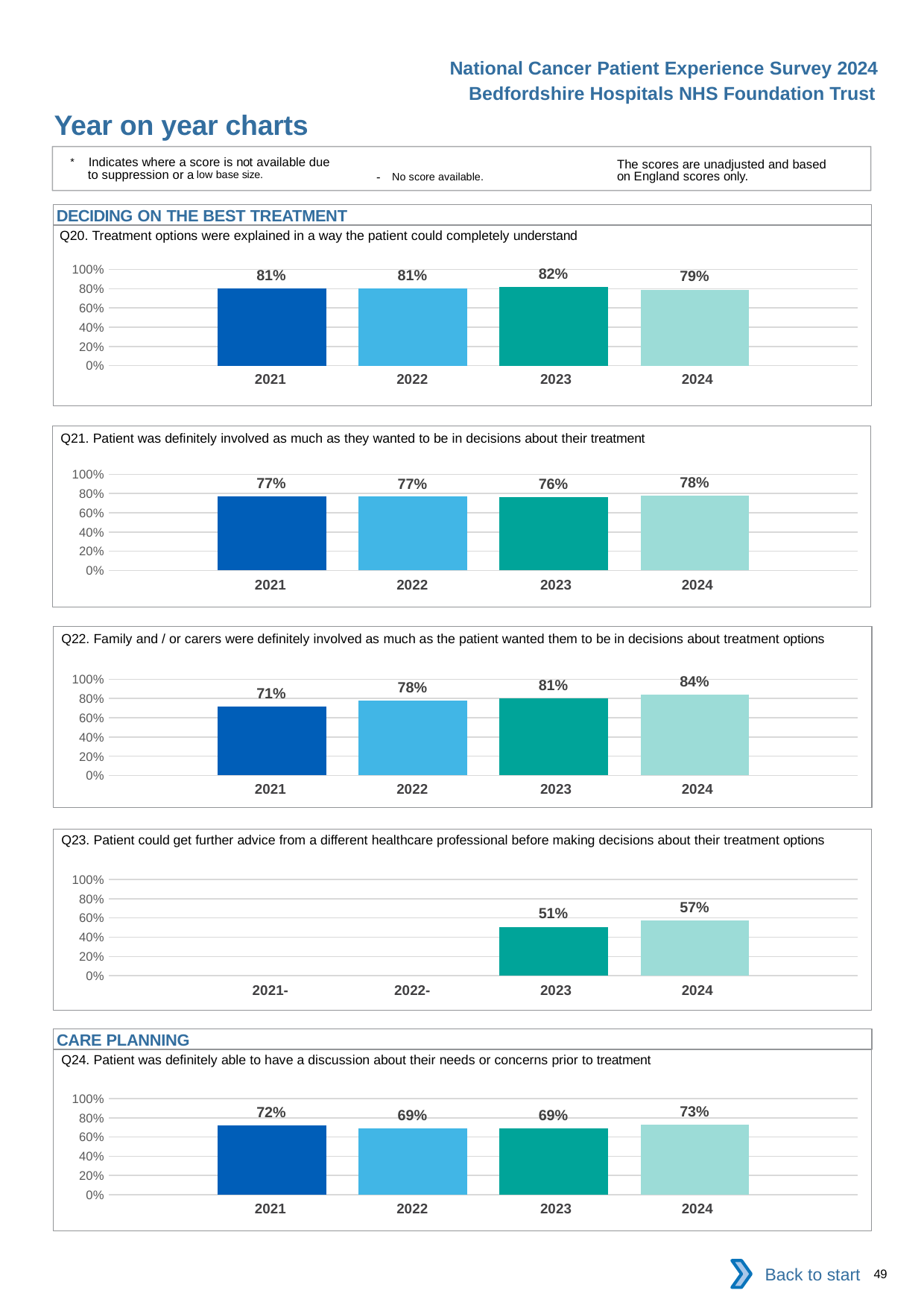
In the Q23 chart, how many years have a bar plotted? 2 What kind of chart is the Q24 chart? bar chart In the Q22 chart, do the values rise or fall from 2021 to 2024? rise In the Q23 chart, what is the value for 2023? 51% In the Q22 chart, what is the difference between the 2024 and 2021 values? 13% In the Q24 chart, which year has the highest value? 2024 In the Q20 chart, what is the value for 2023? 82% In the Q20 chart, which year has the lowest value? 2024 In the Q21 chart, which year has the lowest value? 2023 In the Q23 chart, which is larger, the value for 2023 or 2024? 2024 In the Q22 chart, what is the value for 2021? 71% In the Q21 chart, what is the value for 2024? 78%